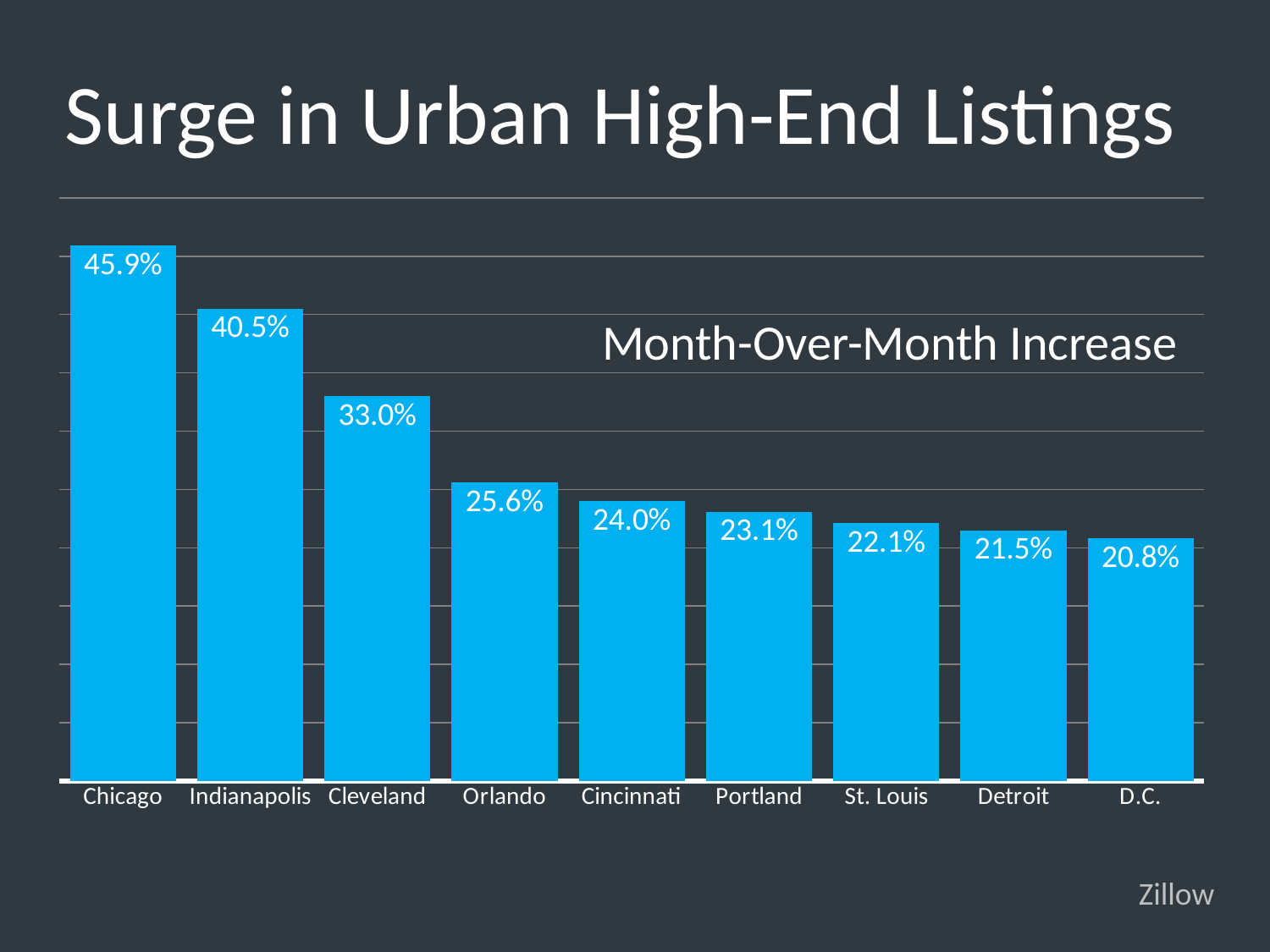
What is the title of the slide? Surge in Urban High-End Listings What is the difference between the values for Chicago and Indianapolis? 5.4% Do the values rise or fall from left to right across the cities? Fall What kind of chart is shown on the slide? Bar chart What is the month-over-month increase for Chicago? 45.9% What is the difference between the values for Cleveland and Orlando? 7.4% What is the value shown for Orlando? 25.6% What is the value shown for D.C.? 20.8% How many cities are shown in the chart? 9 Which has a larger value, Portland or St. Louis? Portland Which city has the highest month-over-month increase? Chicago Which city has the lowest month-over-month increase? D.C.